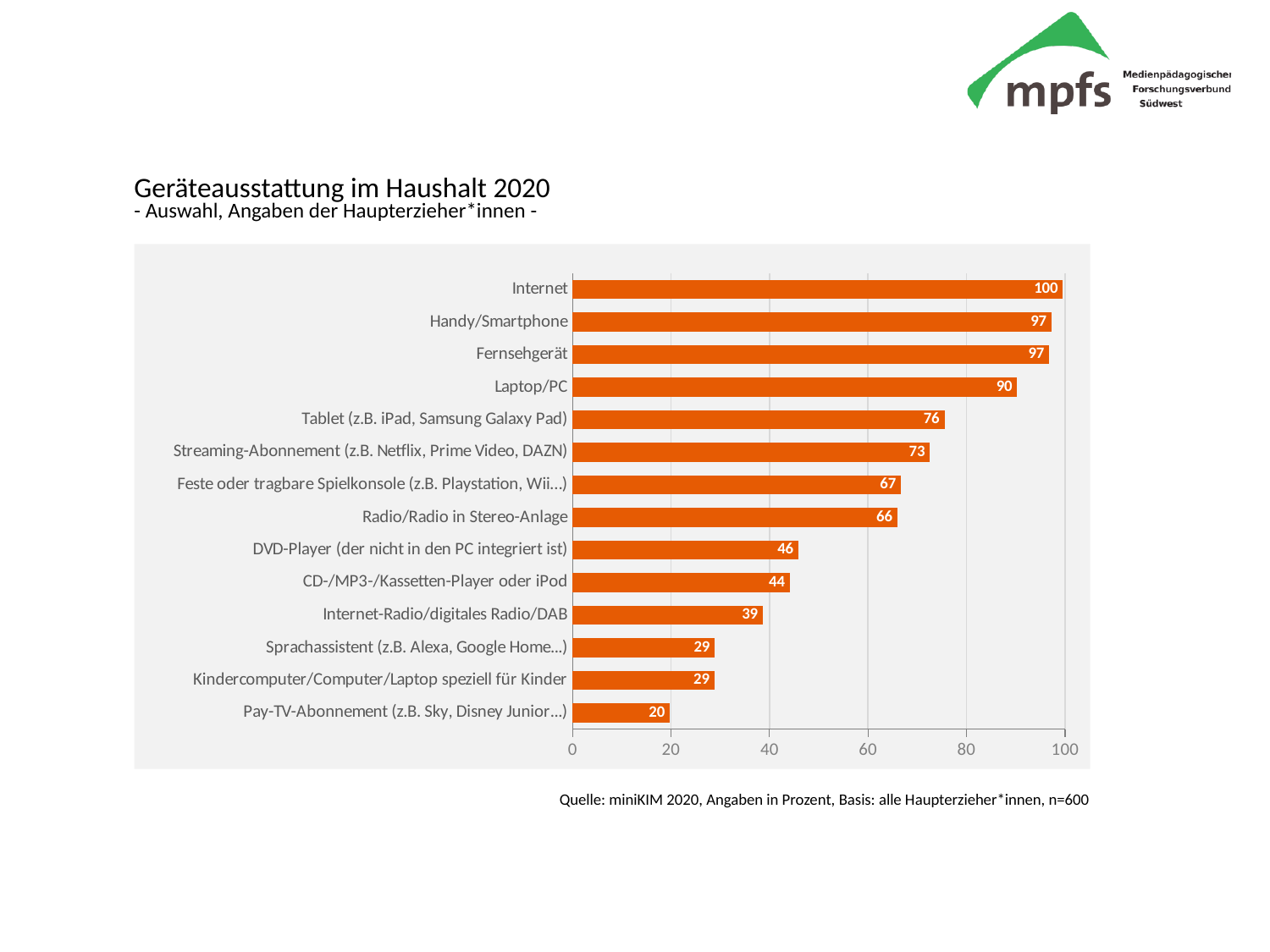
What is the difference between the values for Tablet (z.B. iPad, Samsung Galaxy Pad) and Streaming-Abonnement (z.B. Netflix, Prime Video, DAZN)? 3 Is the value for Feste oder tragbare Spielkonsole (z.B. Playstation, Wii…) greater or less than 60? greater Which category has the lowest value? Pay-TV-Abonnement (z.B. Sky, Disney Junior…) What is the title of the chart? Geräteausstattung im Haushalt 2020 What is the value for Internet-Radio/digitales Radio/DAB? 39 What is the value for Radio/Radio in Stereo-Anlage? 66 What is the difference between the values for Internet and Laptop/PC? 10 How many categories are shown in the chart? 14 What kind of chart is shown on the slide? bar chart Which category has the highest value? Internet What is the value for Laptop/PC? 90 Which is larger, the value for DVD-Player (der nicht in den PC integriert ist) or the value for CD-/MP3-/Kassetten-Player oder iPod? DVD-Player (der nicht in den PC integriert ist)